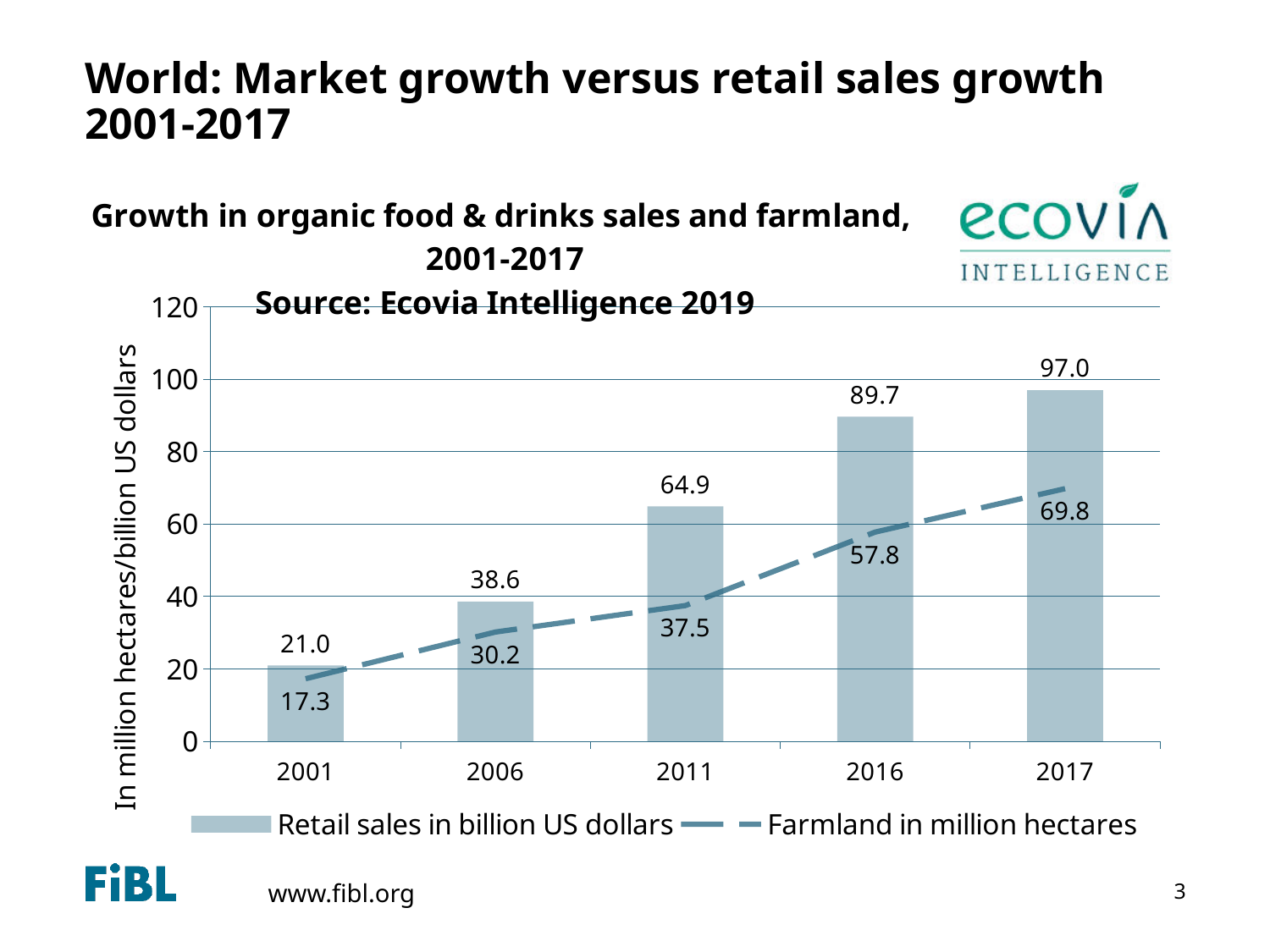
In 2006, which was larger: retail sales in billion US dollars or farmland in million hectares? Retail sales in billion US dollars In which year was retail sales in billion US dollars highest? 2017 Does farmland in million hectares rise or fall from 2001 to 2017? rise In which year was farmland in million hectares lowest? 2001 What was the value of retail sales in billion US dollars in 2001? 21.0 What is the source cited in the chart title? Ecovia Intelligence 2019 What is the difference between retail sales (97.0) and farmland (69.8) in 2017? 27.2 How many years are shown on the x axis of the chart? 5 How many series does the chart legend list? 2 By how much did retail sales in billion US dollars increase from 2016 to 2017? 7.3 What was the value of retail sales in billion US dollars in 2011? 64.9 What was the farmland in million hectares in 2016? 57.8